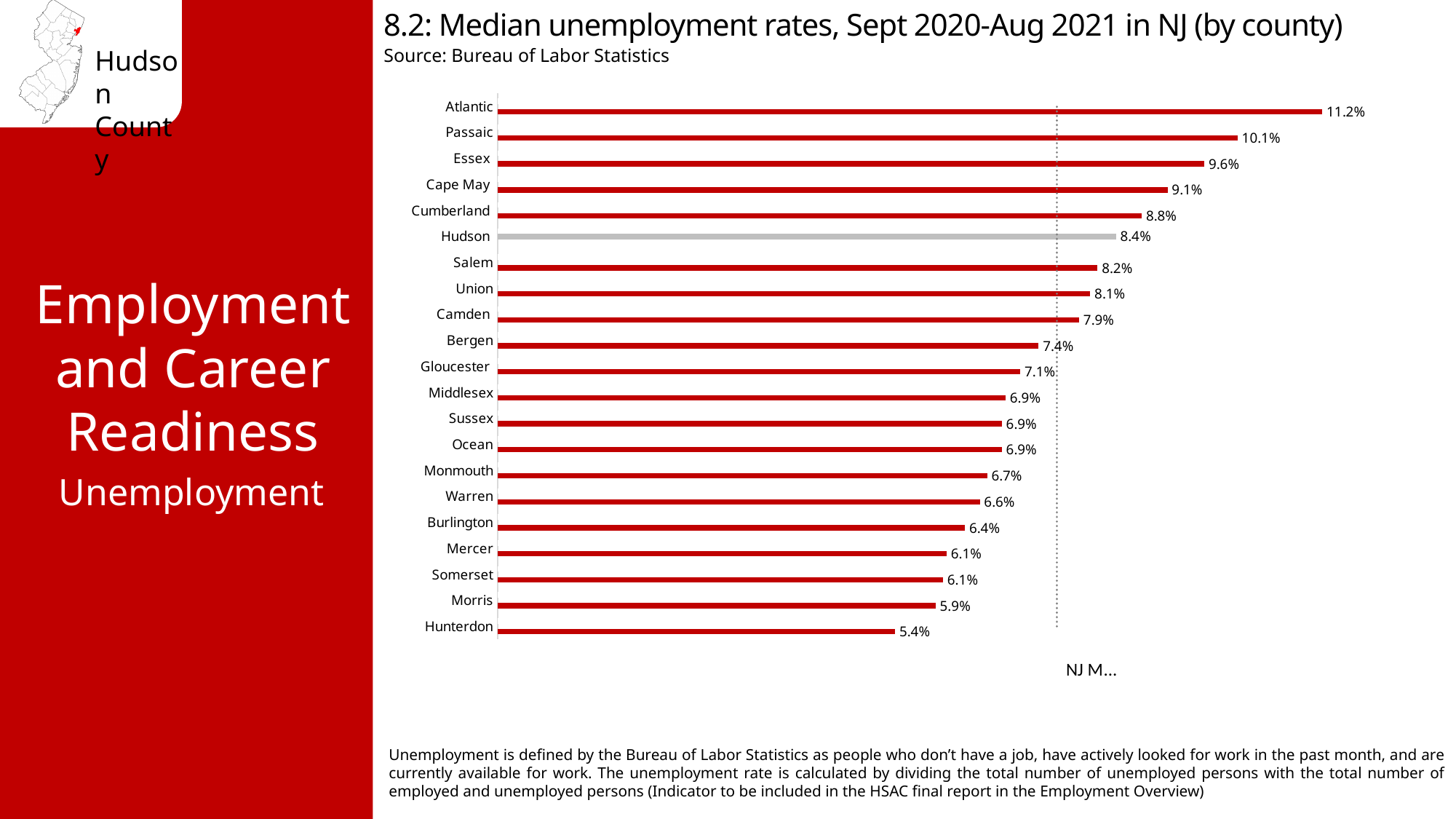
Which county has the lowest median unemployment rate? Hunterdon Which county's bar is shown in grey rather than red? Hudson What is the median unemployment rate for Cape May? 9.1% How many counties are shown in the chart? 21 Which has a higher median unemployment rate, Morris or Warren? Warren What kind of chart is shown on the slide? Bar chart Which has a higher median unemployment rate, Essex or Cumberland? Essex What is the median unemployment rate for Hudson County? 8.4% What is the difference between the median unemployment rates of Atlantic and Hunterdon? 5.8% What is the median unemployment rate for Hunterdon? 5.4% What is the difference between the median unemployment rates of Hudson and Bergen? 1.0% Which county has the highest median unemployment rate? Atlantic